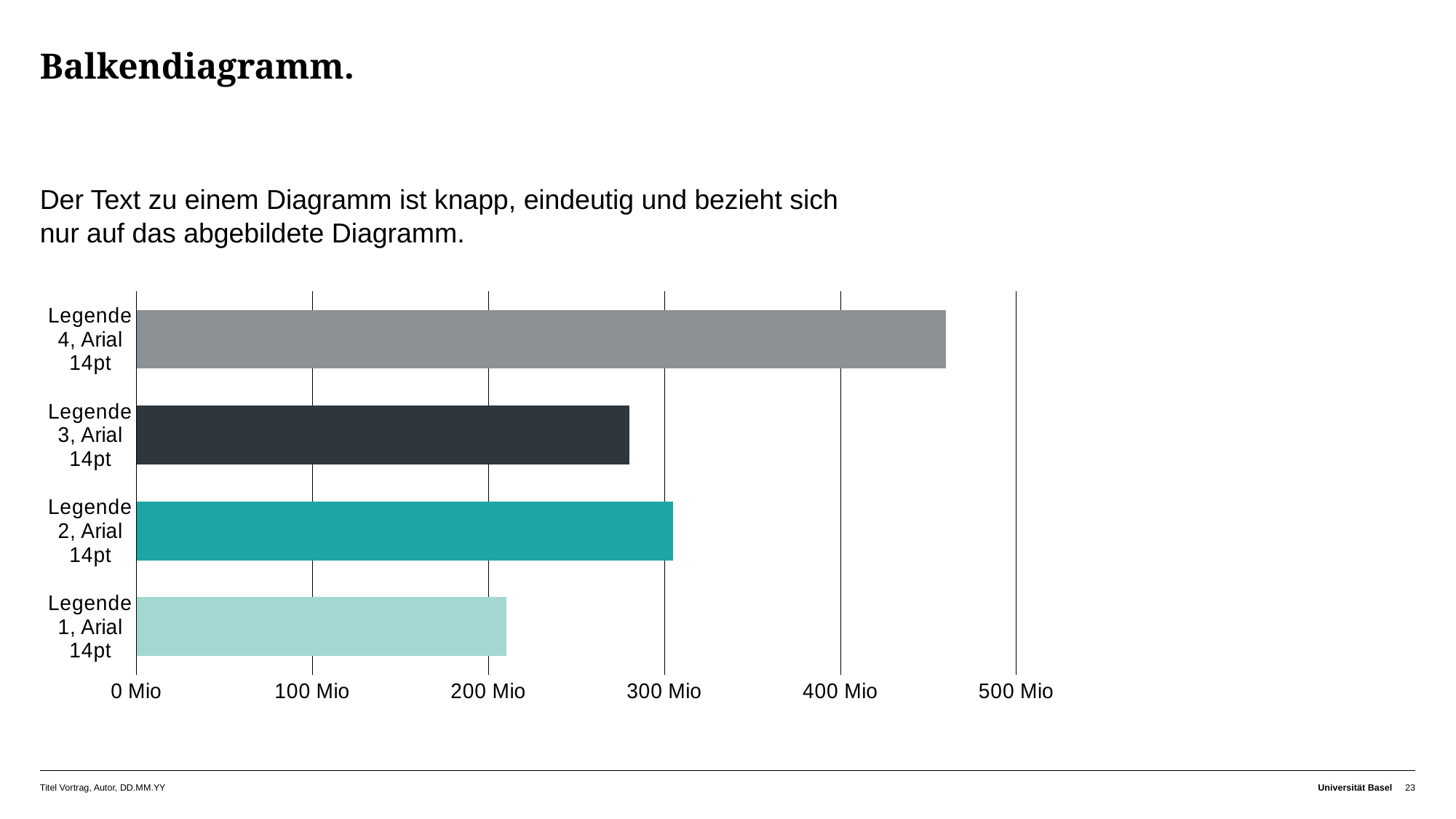
Which category has the highest value? Legende 4, Arial 14pt Is the value for Legende 2, Arial 14pt greater or less than 400 Mio? less Is the value for Legende 4, Arial 14pt greater or less than 500 Mio? less What kind of chart is shown on the slide? bar chart Is the value for Legende 1, Arial 14pt greater or less than 300 Mio? less Which is larger, the value for Legende 1, Arial 14pt or the value for Legende 4, Arial 14pt? Legende 4, Arial 14pt What is the title of the slide containing the chart? Balkendiagramm. Which category has the lowest value? Legende 1, Arial 14pt How many bars does the chart show? 4 Which is larger, the value for Legende 2, Arial 14pt or the value for Legende 3, Arial 14pt? Legende 2, Arial 14pt